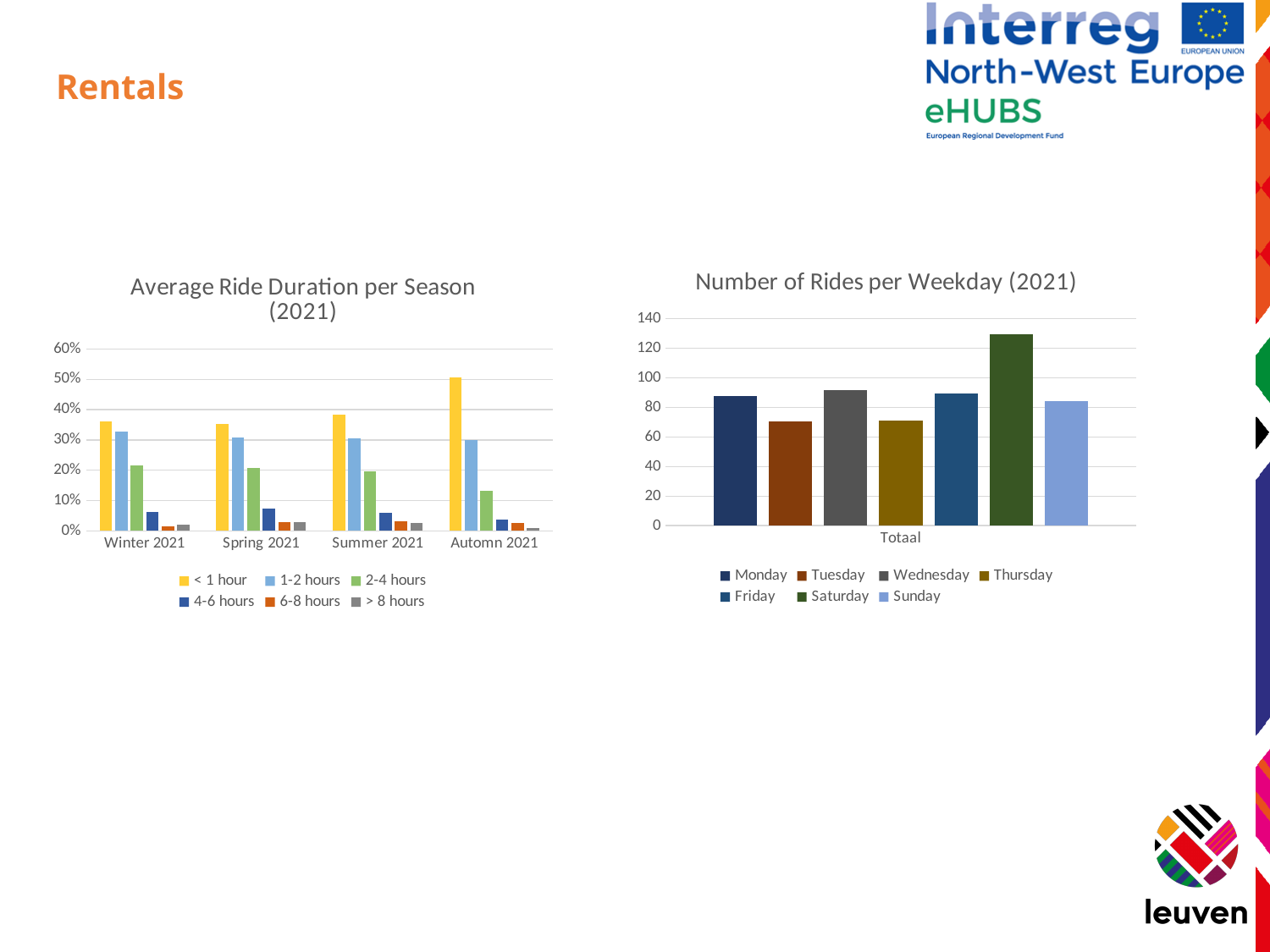
How many seasons are shown on the x axis of the 'Average Ride Duration per Season (2021)' chart? 4 On the 'Average Ride Duration per Season (2021)' chart, which season has the lowest value for '2-4 hours'? Automn 2021 On the 'Number of Rides per Weekday (2021)' chart, is the value for Tuesday greater or less than 80? less On the 'Number of Rides per Weekday (2021)' chart, which weekday has the highest number of rides? Saturday How many series does the legend of the 'Average Ride Duration per Season (2021)' chart list? 6 On the 'Average Ride Duration per Season (2021)' chart, is the '< 1 hour' value for Autumn 2021 greater or less than 40%? greater On the 'Average Ride Duration per Season (2021)' chart, which season has the highest value for '< 1 hour'? Automn 2021 How many series does the legend of the 'Number of Rides per Weekday (2021)' chart list? 7 On the 'Number of Rides per Weekday (2021)' chart, which is larger, the value for Wednesday or the value for Tuesday? Wednesday What kind of chart is 'Number of Rides per Weekday (2021)'? bar chart On the 'Number of Rides per Weekday (2021)' chart, is the value for Saturday greater or less than 120? greater What is the category label on the x axis of the 'Number of Rides per Weekday (2021)' chart? Totaal